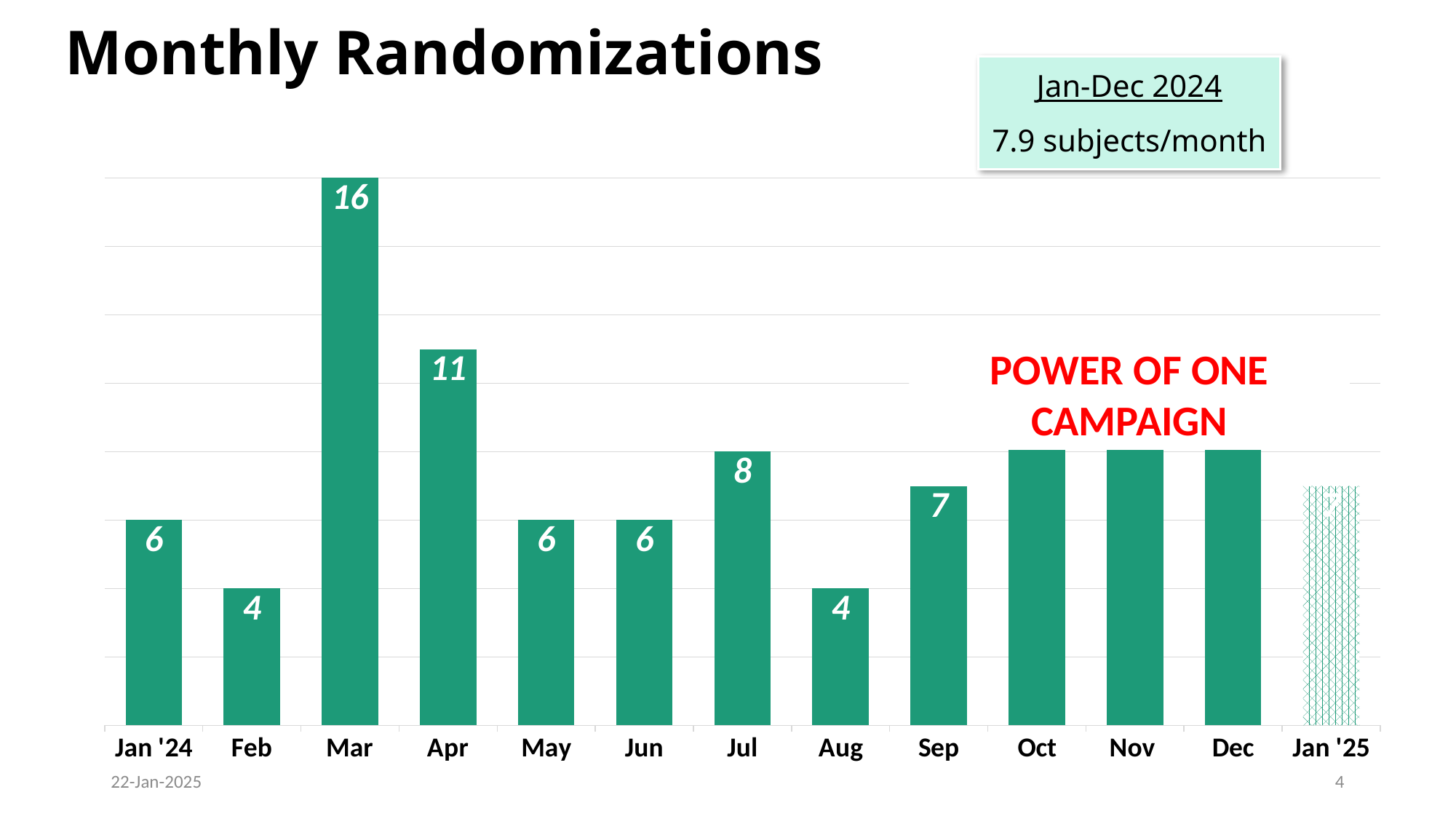
What is the value for Jan '24? 6 Which month has the highest value? Mar What average rate is stated in the box for Jan-Dec 2024? 7.9 subjects/month Which is larger, the value for Feb or the value for Jul? Jul How many months are shown on the x axis? 13 What is the value for Apr? 11 What is the value for Sep? 7 What is the difference between the values for Jul and Aug? 4 What is the value for Mar? 16 What kind of chart is this? Bar chart Which is larger, the value for Oct or the value for Aug? Oct What is the difference between the values for Mar and Apr? 5